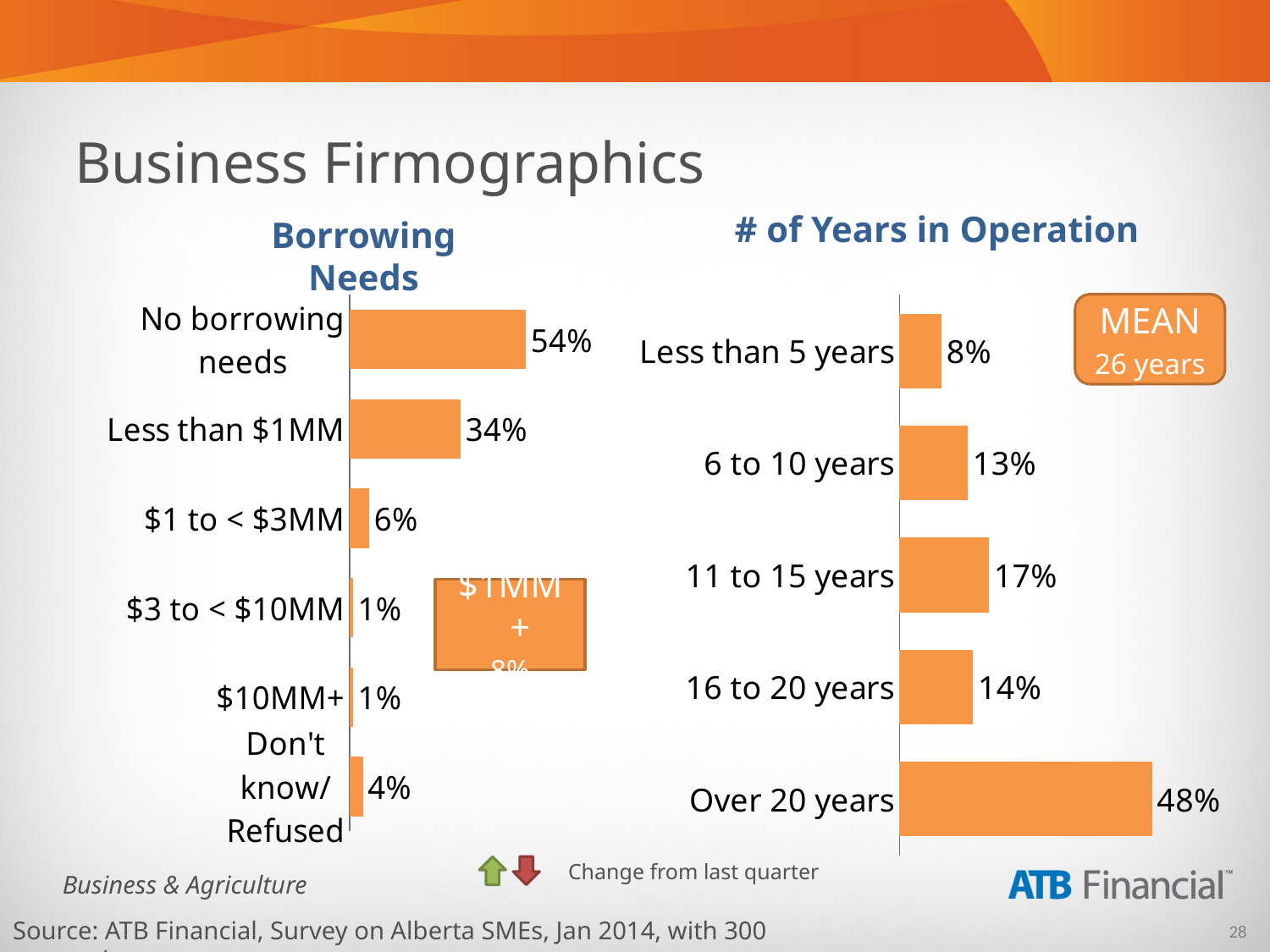
In the Borrowing Needs chart, what is the value for No borrowing needs? 54% What mean number of years in operation is shown on the slide? 26 years In the # of Years in Operation chart, what is the value for 11 to 15 years? 17% What kind of chart is the # of Years in Operation chart? Bar chart In the Borrowing Needs chart, which category has the highest value? No borrowing needs In the # of Years in Operation chart, which is larger, 6 to 10 years or 16 to 20 years? 16 to 20 years In the Borrowing Needs chart, what is the difference between No borrowing needs and Less than $1MM? 20% In the Borrowing Needs chart, what is the value for Less than $1MM? 34% In the # of Years in Operation chart, what is the difference between Over 20 years and 16 to 20 years? 34% In the # of Years in Operation chart, what is the value for Over 20 years? 48% In the Borrowing Needs chart, how many categories are shown? 6 In the # of Years in Operation chart, which category has the lowest value? Less than 5 years